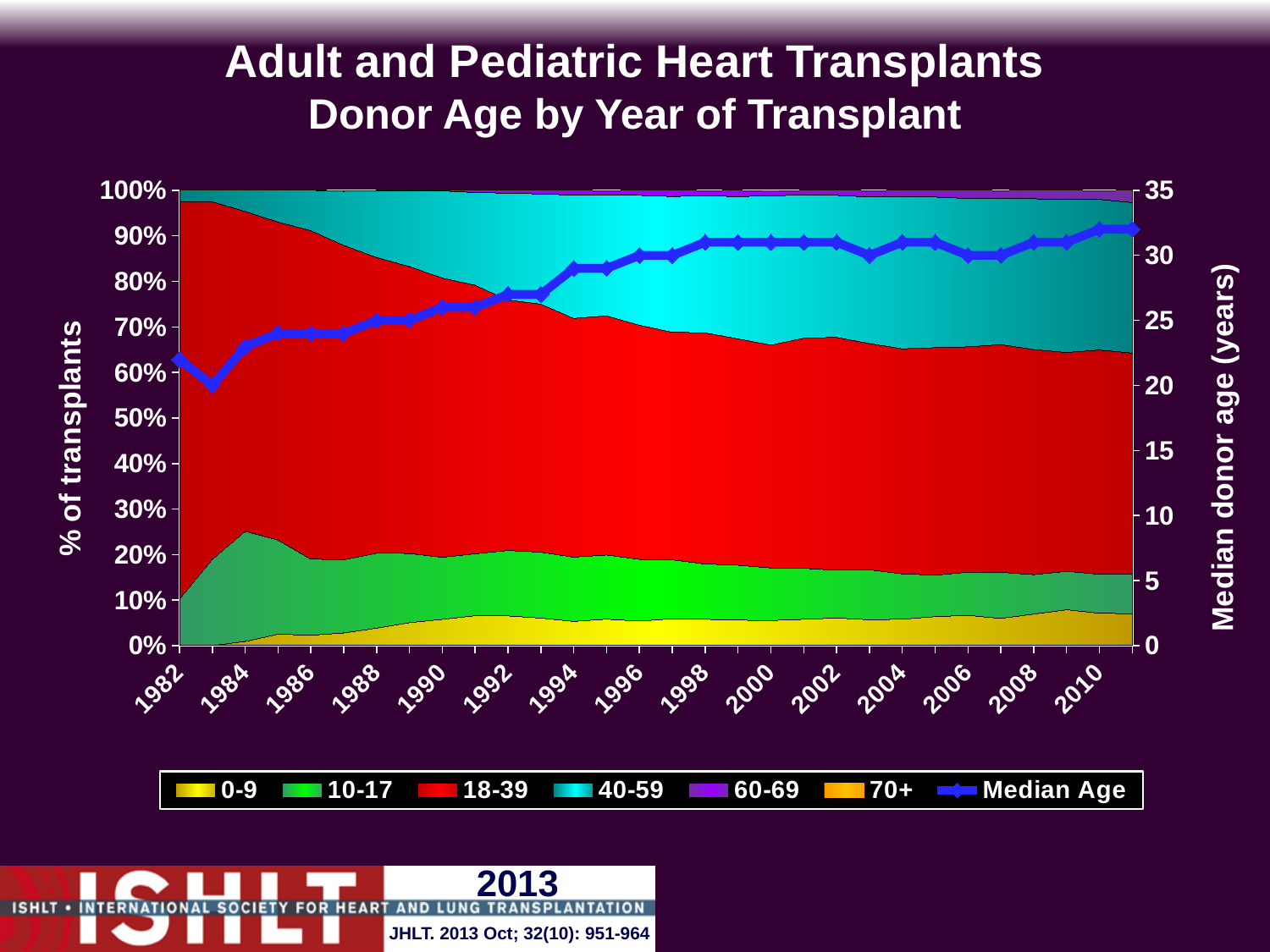
How many year labels are shown on the x axis? 15 Does the share of the 18-39 donor age group rise or fall from 1982 to 2010? Fall In which year is the Median Age at its lowest? 1983 What kind of chart is shown on the slide? Stacked area chart with a line overlay Is the Median Age value for 2010 greater or less than 30? greater What is the title of the chart? Adult and Pediatric Heart Transplants Donor Age by Year of Transplant What is the label of the right-hand vertical axis? Median donor age (years) Does the share of the 40-59 donor age group rise or fall from 1982 to 2010? Rise How many series does the legend list? 7 Does the Median Age line generally rise or fall from 1982 to 2010? Rise Is the Median Age value for 1990 greater or less than 30? less Is the Median Age value for 1998 greater or less than 25? greater